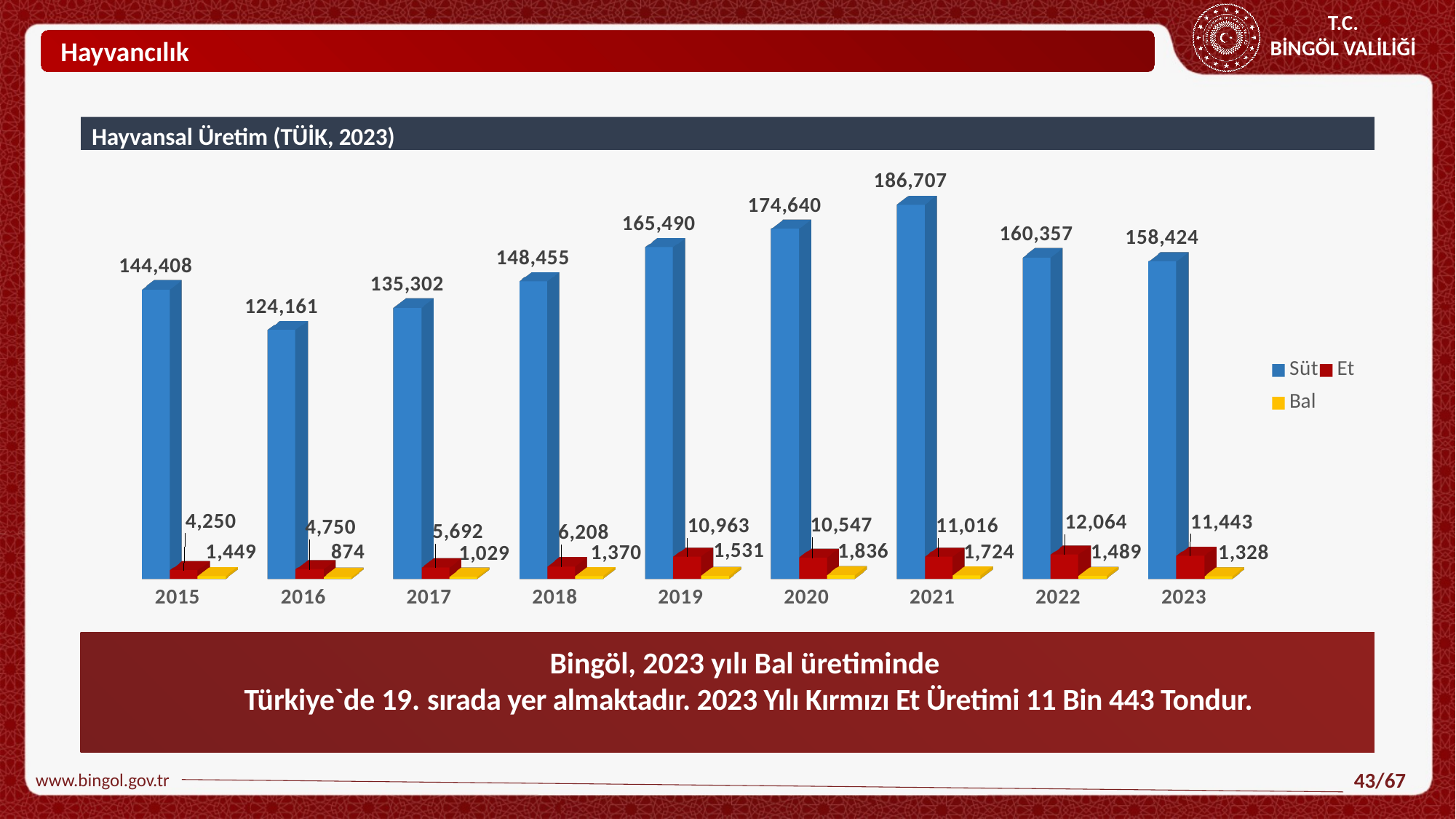
How many years are shown on the x axis? 9 Which year has the lowest Süt value? 2016 What is the Bal value for 2016? 874 What kind of chart is shown on the slide? Bar chart What is the Et value for 2019? 10,963 Which year has the lowest Bal value? 2016 Which year has the highest Süt value? 2021 Which year has the highest Et value? 2022 Which is larger, the Bal value for 2020 or the Bal value for 2023? 2020 What is the Süt value for 2021? 186,707 How many series does the legend list? 3 What is the difference between the Süt values for 2021 and 2020? 12,067